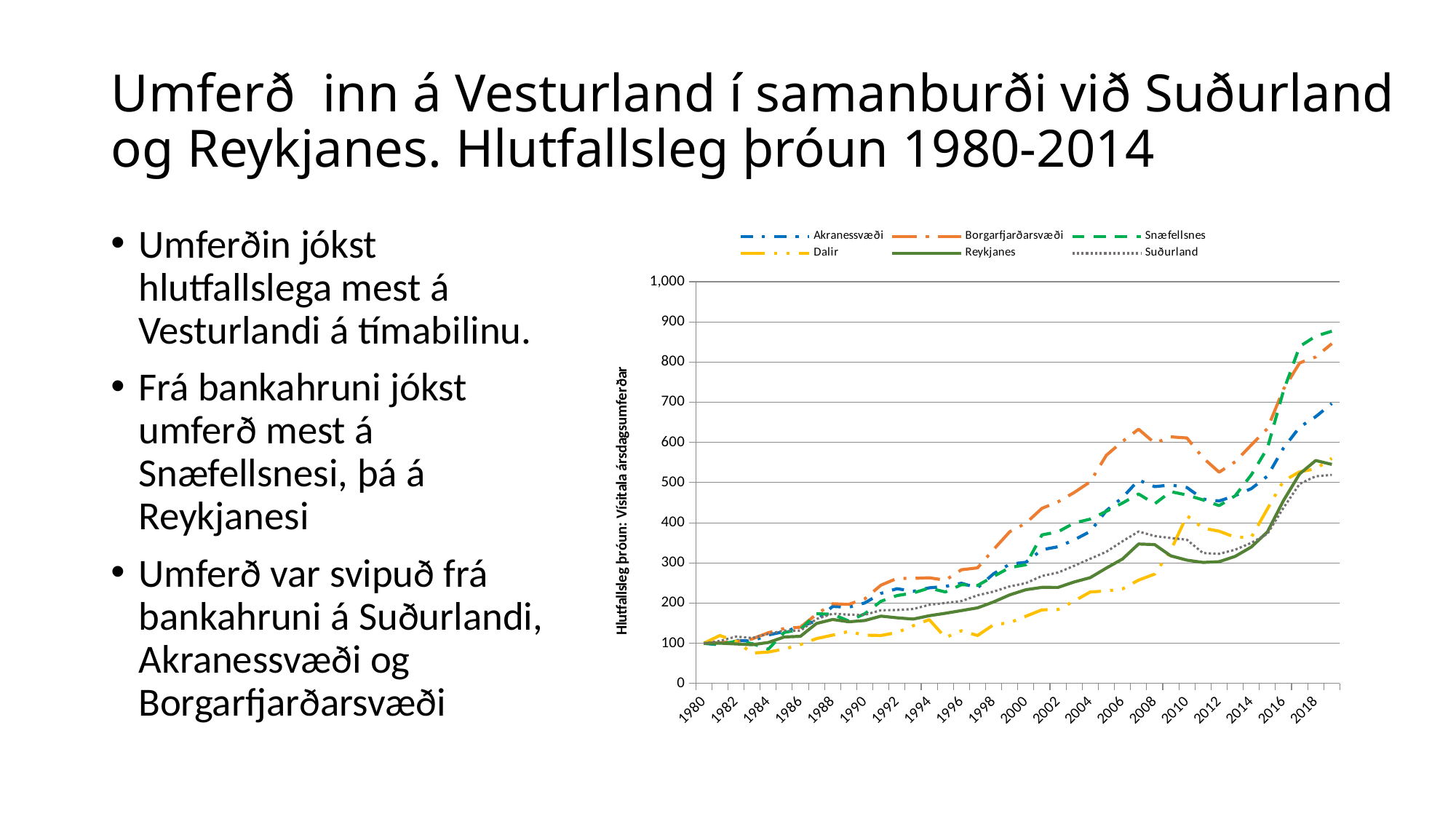
Is the value for Dalir in 1984 greater or less than 100? less Is the value for Snæfellsnes in 2018 greater or less than 800? greater Does the value for Borgarfjarðarsvæði generally rise or fall from 1980 to 2018? rise How many series does the chart legend list? 6 What is the title of the vertical axis of the chart? Hlutfallsleg þróun: Vísitala ársdagsumferðar In 2008, which is larger: the value for Borgarfjarðarsvæði or the value for Reykjanes? Borgarfjarðarsvæði What kind of chart is shown on the slide? line chart Which series has the lowest value in 1984? Dalir Which series has the highest value in 2008? Borgarfjarðarsvæði What is the value for Akranessvæði in 1980? 100 Which series is drawn as a solid green line in the chart? Reykjanes